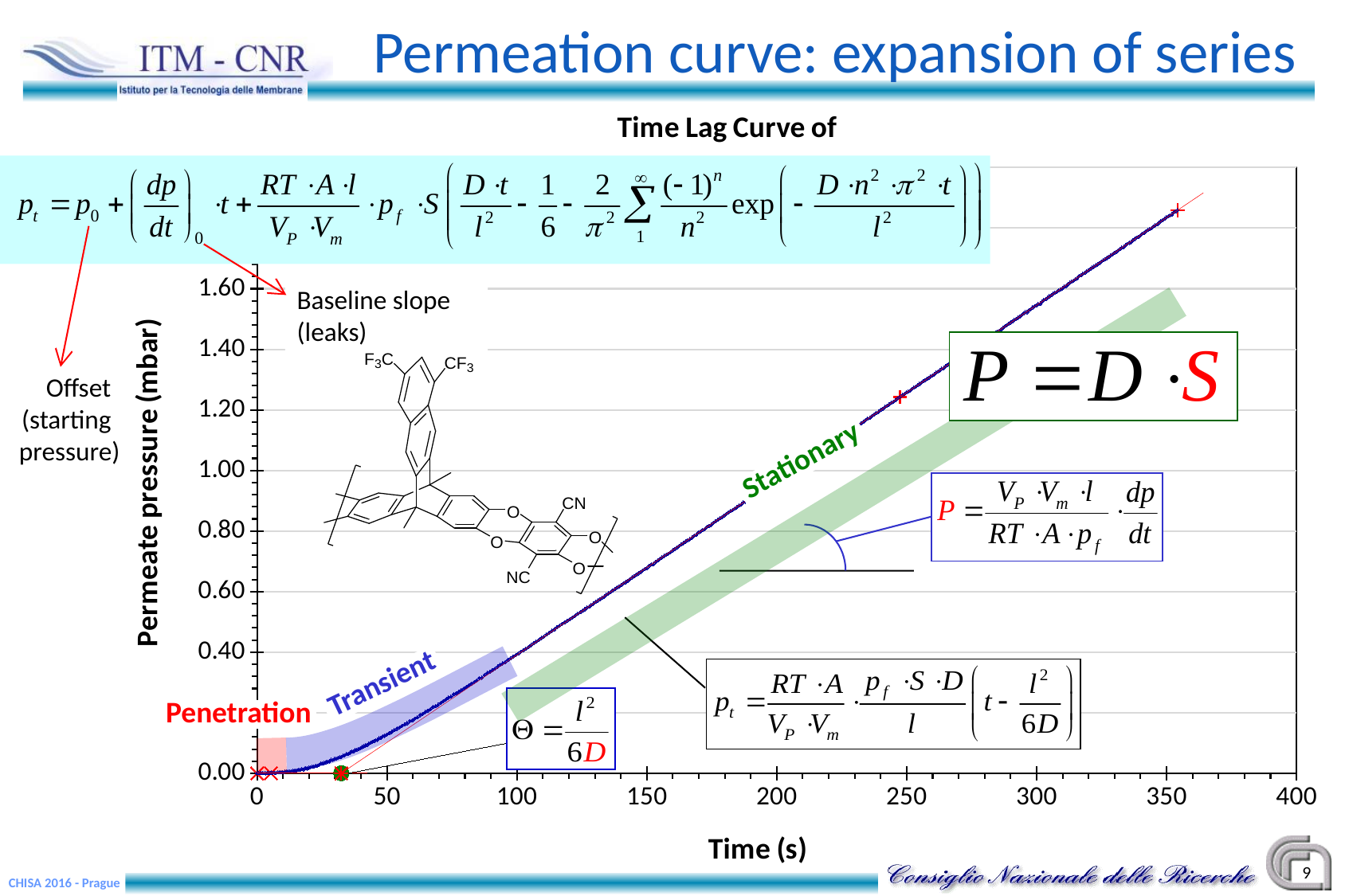
Is the permeate pressure at 350 s greater or less than 1.40 mbar? greater What is the title of the x axis of the chart? Time (s) Does the permeate pressure rise or fall as time increases along the x axis? rises Is the permeate pressure at 250 s greater or less than 1.40 mbar? less What is the title of the y axis of the chart? Permeate pressure (mbar) Is the permeate pressure at 50 s greater or less than 0.40 mbar? less Which is larger, the permeate pressure at 150 s or at 300 s? 300 s What kind of chart is shown on the slide? line chart What is the highest value labelled on the x axis of the chart? 400